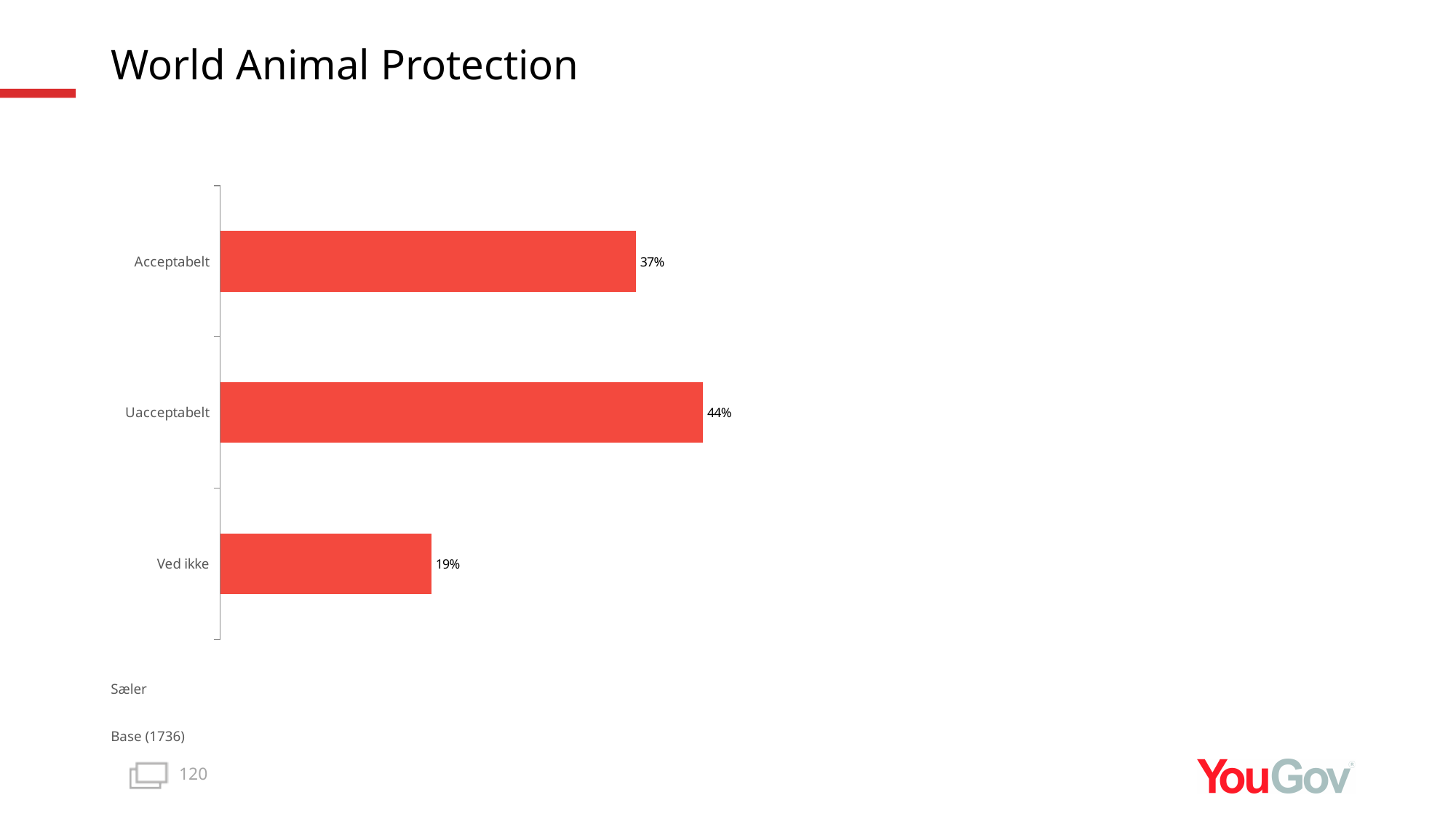
What is the value for Acceptabelt? 37% What is the value for Ved ikke? 19% Which category has the lowest value? Ved ikke How many categories are shown in the chart? 3 Which category has the highest value? Uacceptabelt What is the value for Uacceptabelt? 44% Which is larger, Acceptabelt or Ved ikke? Acceptabelt What is the difference between Uacceptabelt and Acceptabelt? 7% What kind of chart is shown on the slide? Bar chart What base size is stated below the chart? 1736 What is the difference between Acceptabelt and Ved ikke? 18% What is the title of the slide? World Animal Protection